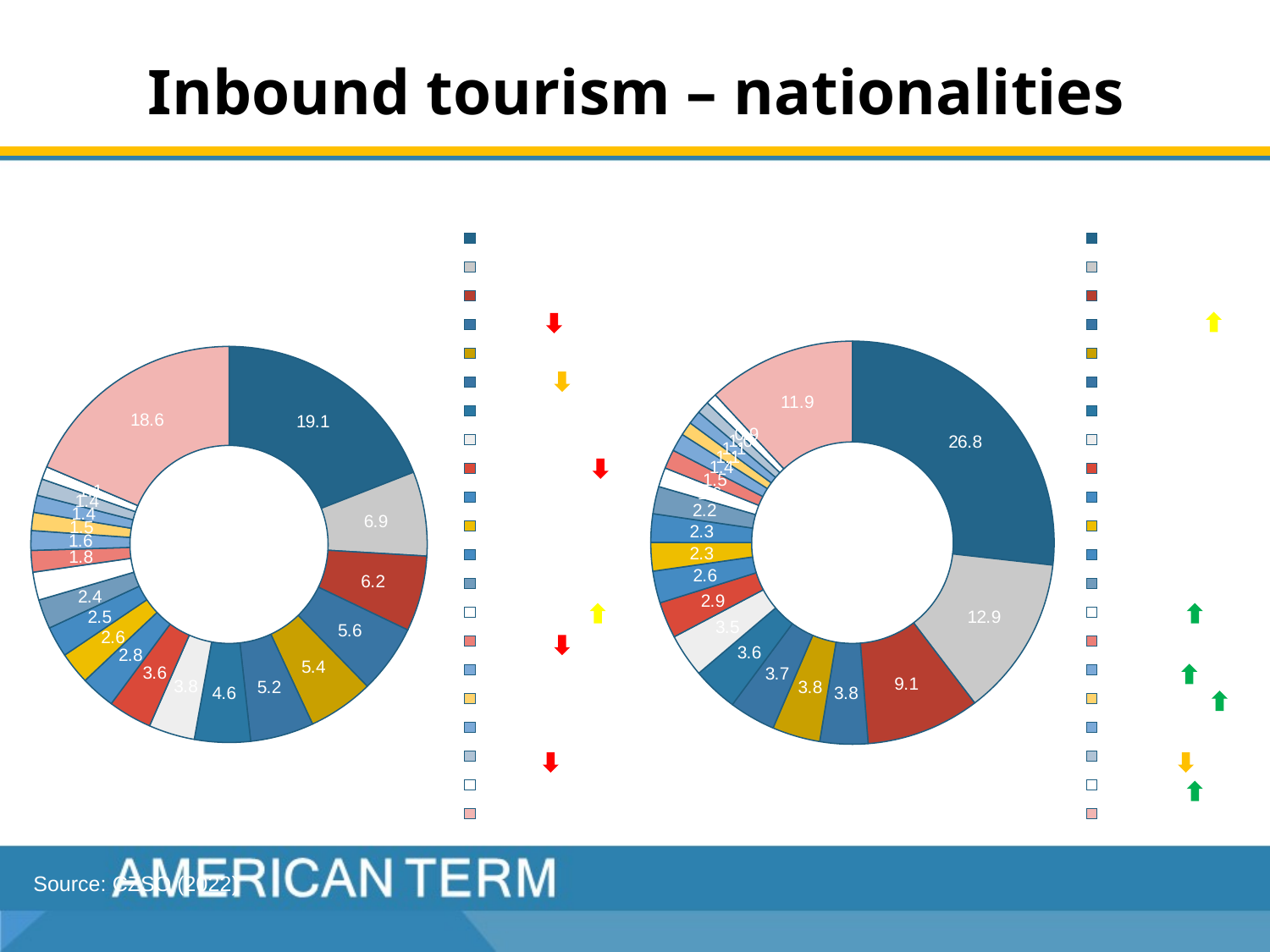
On the right chart, what is the difference between the two largest slice values (26.8 and 12.9)? 13.9 What kind of chart is the left chart on the slide? doughnut chart How many charts are shown on the slide? 2 On the left chart, what is the value of the pink slice? 18.6 On the right chart, what is the value of the largest slice? 26.8 Which chart has the larger single largest slice, the left chart or the right chart? right chart On the left chart, what is the difference between the two largest slice values (19.1 and 18.6)? 0.5 On the left chart, what is the value of the largest slice? 19.1 What is the title of the slide? Inbound tourism – nationalities On the left chart, what is the value of the light grey slice? 6.9 On the right chart, what is the value of the light grey slice? 12.9